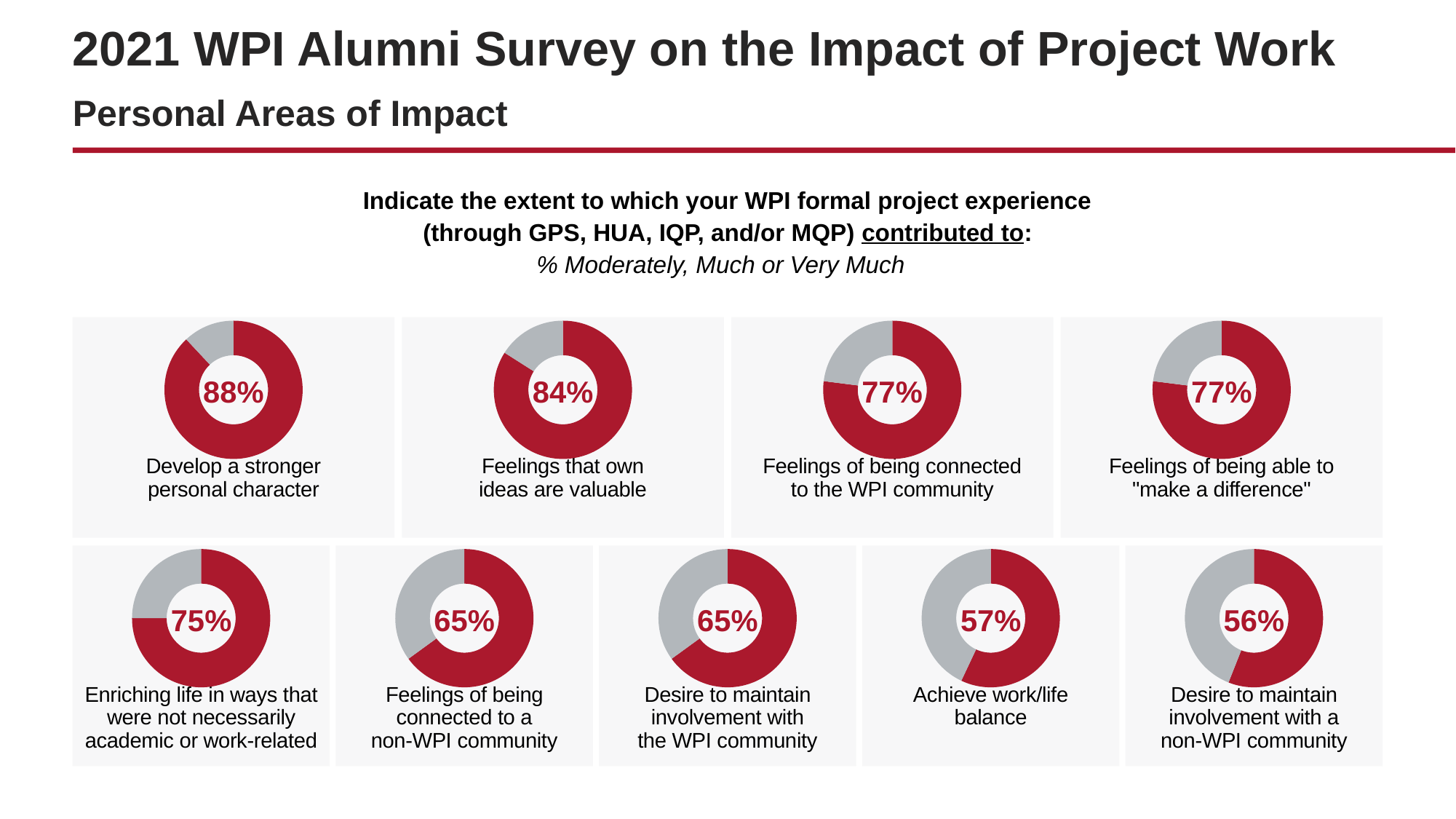
What percentage is shown in the donut chart labeled "Feelings of being able to "make a difference""? 77% What kind of chart is used to display each percentage on the slide? Donut (pie) chart What is the difference in percentage points between "Develop a stronger personal character" and "Feelings that own ideas are valuable"? 4 What percentage is shown in the donut chart labeled "Develop a stronger personal character"? 88% What is the difference in percentage points between "Develop a stronger personal character" and "Desire to maintain involvement with a non-WPI community"? 32 Which has a higher percentage: "Enriching life in ways that were not necessarily academic or work-related" or "Feelings of being connected to a non-WPI community"? Enriching life in ways that were not necessarily academic or work-related What percentage is shown in the donut chart labeled "Desire to maintain involvement with a non-WPI community"? 56% How many donut charts are shown on the slide? 9 What percentage is shown in the donut chart labeled "Achieve work/life balance"? 57% What percentage is shown in the donut chart labeled "Feelings that own ideas are valuable"? 84% Which personal area of impact has the highest percentage on the slide? Develop a stronger personal character Which personal area of impact has the lowest percentage on the slide? Desire to maintain involvement with a non-WPI community